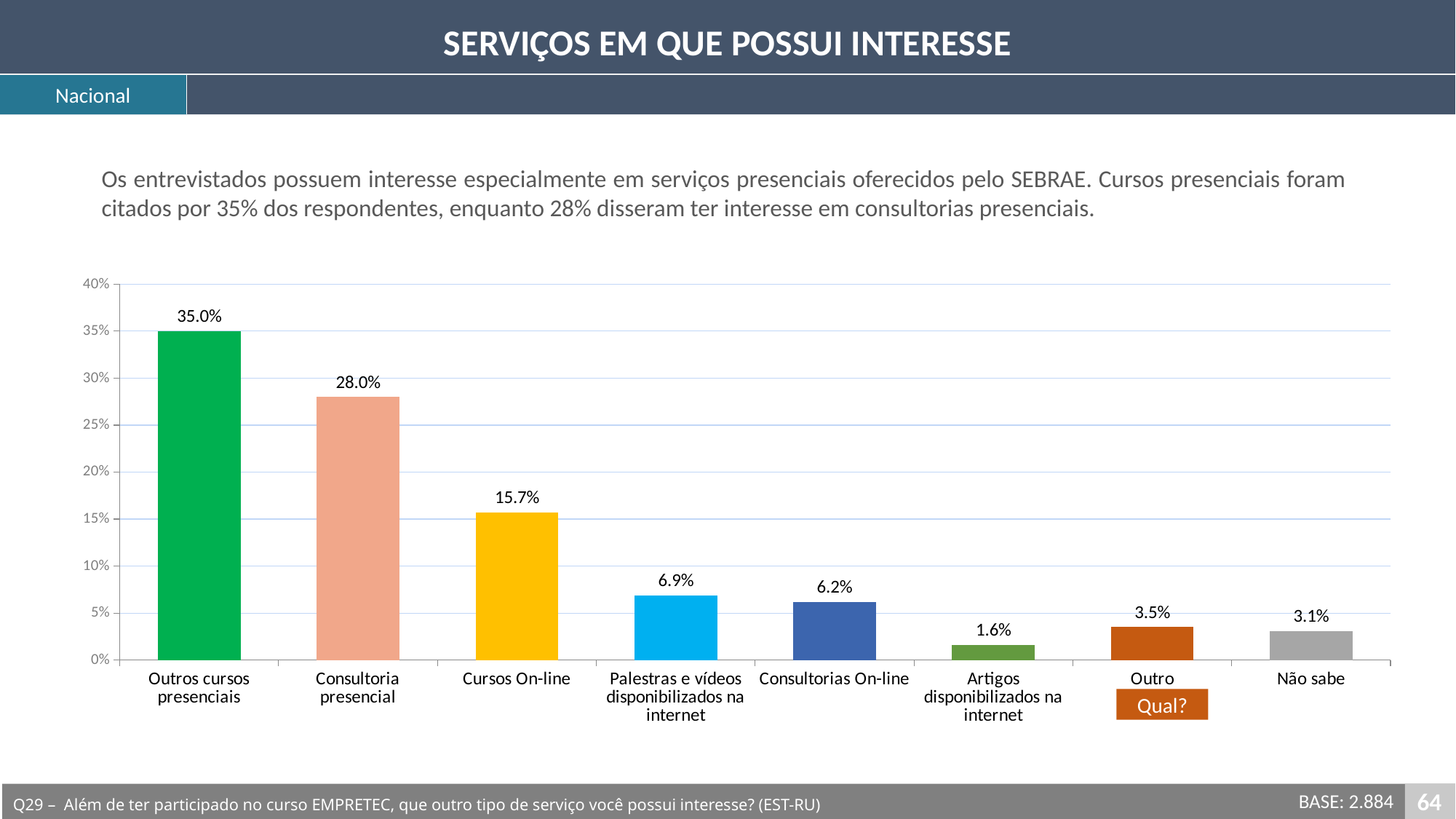
What kind of chart is shown on the slide? bar chart How many categories are shown on the x axis? 8 Which category has the lowest value? Artigos disponibilizados na internet What is the value for Cursos On-line? 15.7% What is the value for Artigos disponibilizados na internet? 1.6% What is the value for Não sabe? 3.1% Which category has the highest value? Outros cursos presenciais What is the value for Consultoria presencial? 28.0% What is the difference between the values for Outros cursos presenciais and Consultoria presencial? 7.0% What is the value for Outros cursos presenciais? 35.0% Is the value for Cursos On-line greater or less than 20%? less Which is larger, the value for Palestras e vídeos disponibilizados na internet or the value for Consultorias On-line? Palestras e vídeos disponibilizados na internet